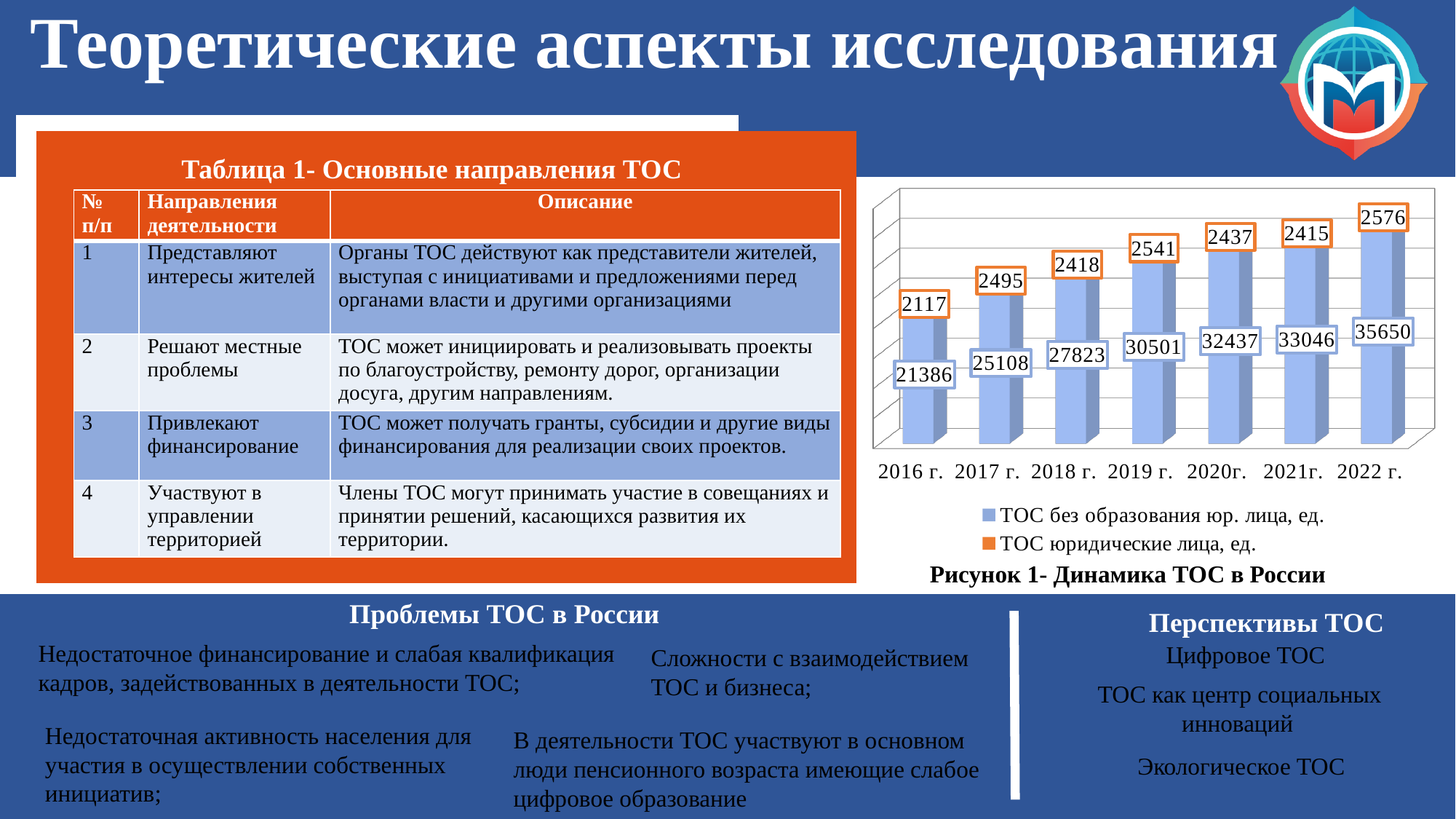
What kind of chart is 'Рисунок 1- Динамика ТОС в России'? Bar chart In the chart 'Рисунок 1- Динамика ТОС в России', what is the difference between the 'ТОС без образования юр. лица, ед.' values for 2022 г. and 2016 г.? 14264 In the chart 'Рисунок 1- Динамика ТОС в России', what is the value for 'ТОС без образования юр. лица, ед.' in 2019 г.? 30501 In the chart 'Рисунок 1- Динамика ТОС в России', what is the value for 'ТОС юридические лица, ед.' in 2022 г.? 2576 How many series does the legend of the chart 'Рисунок 1- Динамика ТОС в России' list? 2 In the chart 'Рисунок 1- Динамика ТОС в России', which is larger for 'ТОС юридические лица, ед.': 2017 г. or 2018 г.? 2017 г. In the chart 'Рисунок 1- Динамика ТОС в России', do the values for 'ТОС без образования юр. лица, ед.' rise or fall from 2016 г. to 2022 г.? Rise How many years are shown on the x axis of the chart 'Рисунок 1- Динамика ТОС в России'? 7 In the chart 'Рисунок 1- Динамика ТОС в России', what is the value for 'ТОС без образования юр. лица, ед.' in 2016 г.? 21386 In the chart 'Рисунок 1- Динамика ТОС в России', what colour represents the series 'ТОС юридические лица, ед.'? Orange In the chart 'Рисунок 1- Динамика ТОС в России', which year has the lowest value for 'ТОС юридические лица, ед.'? 2016 г. In the chart 'Рисунок 1- Динамика ТОС в России', which year has the highest value for 'ТОС без образования юр. лица, ед.'? 2022 г.